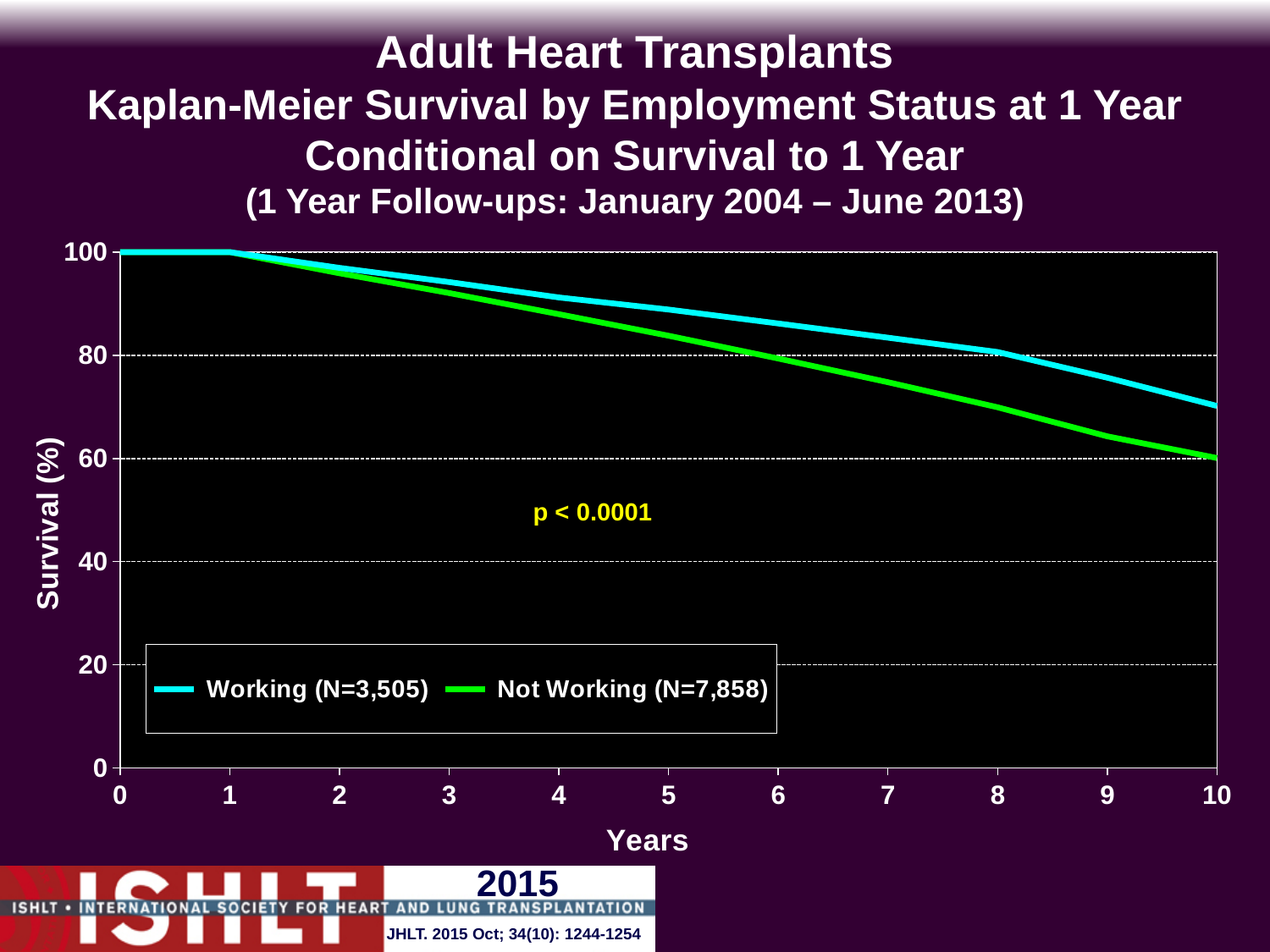
Which series has the higher survival at 10 years, Working or Not Working? Working What is the survival value for both groups at 1 year? 100 What is the sample size (N) for the Working group shown in the legend? 3,505 Do the survival curves rise or fall as years increase? fall How many series does the legend list? 2 Is the survival value for the Working group at 5 years greater or less than 80? greater Is the survival value for the Not Working group at 8 years greater or less than 80? less Is the survival value for the Not Working group at 4 years greater or less than 80? greater What type of chart is shown on the slide? line chart What p-value is printed on the chart? p < 0.0001